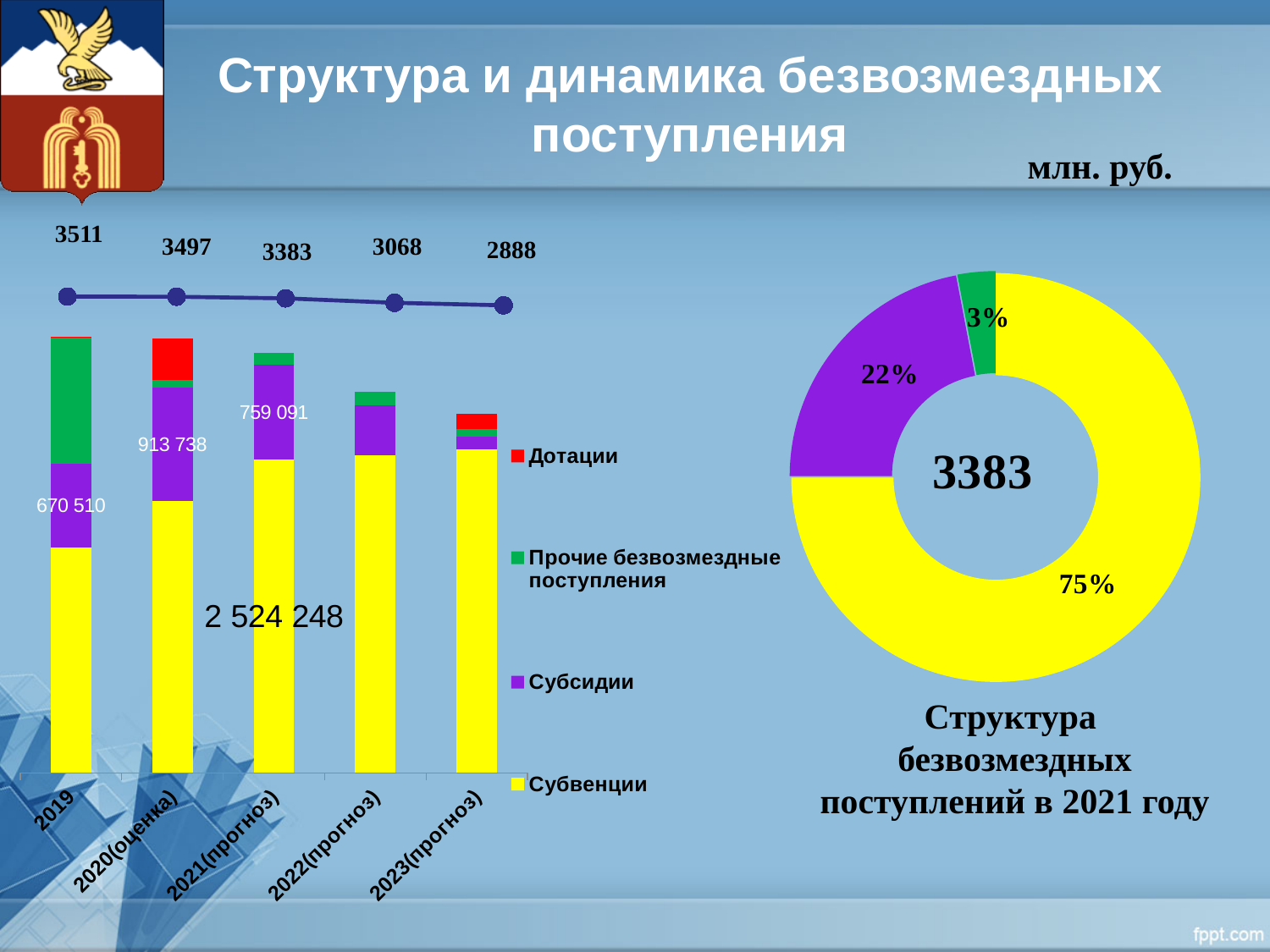
In the left chart, how many years are shown on the x axis? 5 In the left chart, what total value is shown for 2023(прогноз)? 2888 In the doughnut chart 'Структура безвозмездных поступлений в 2021 году', what value is shown in the centre? 3383 In the left chart, do the total values rise or fall from 2019 to 2023(прогноз)? fall In the left chart, what total value is shown above the 2019 bar? 3511 In the left chart, which year has the lowest total value? 2023(прогноз) In the left chart, which year has the highest total value? 2019 In the left chart, which total is larger: 2021(прогноз) or 2022(прогноз)? 2021(прогноз) In the left chart, how many series does the legend list? 4 In the doughnut chart 'Структура безвозмездных поступлений в 2021 году', what share does the largest (yellow) slice have? 75% In the left chart, what total value is shown for 2021(прогноз)? 3383 In the left chart, what is the difference between the total for 2019 and the total for 2023(прогноз)? 623